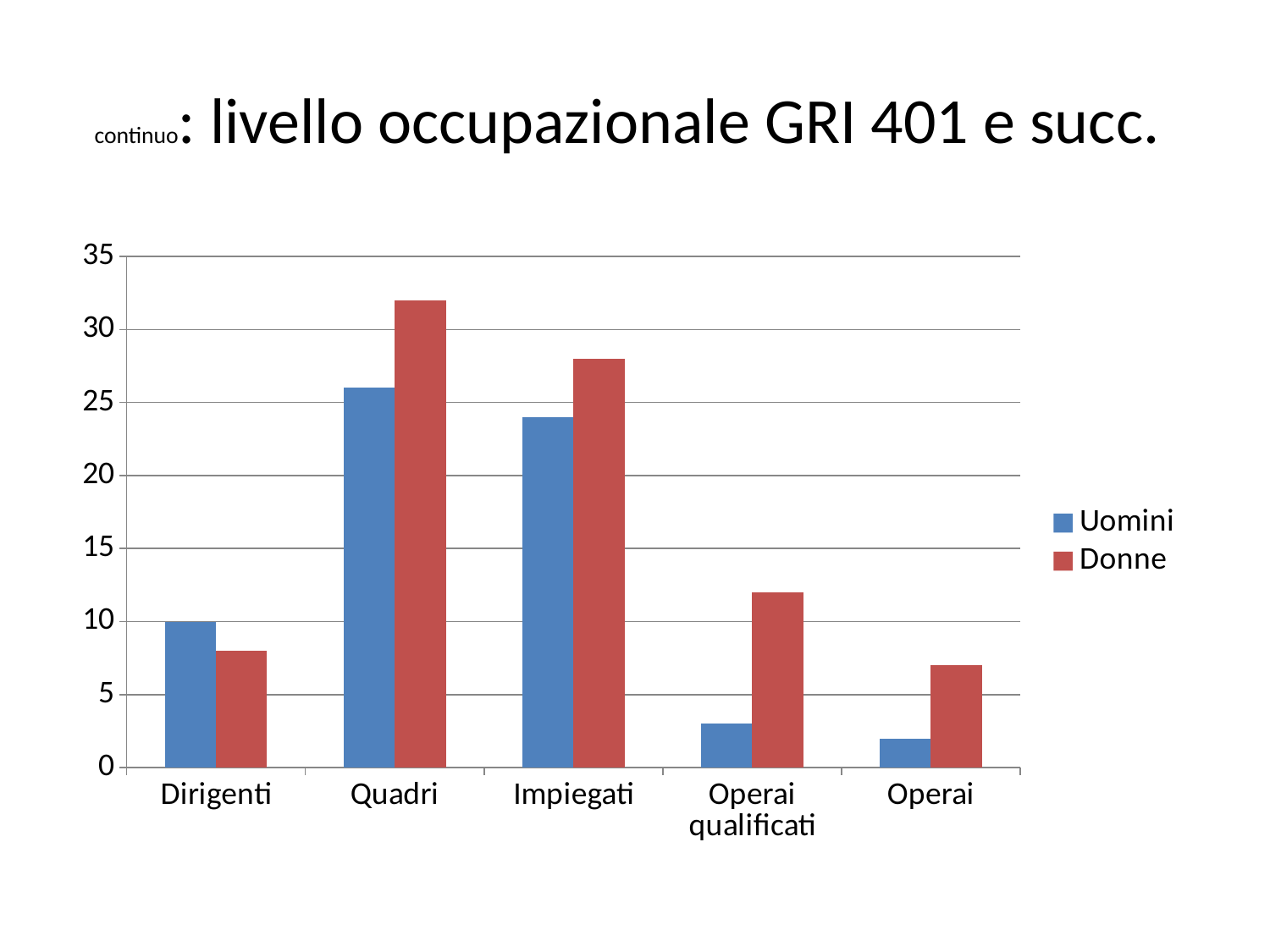
What kind of chart is shown on the slide? bar chart Which category has the highest Uomini value? Quadri Which series is shown in red? Donne How many categories are shown on the x axis? 5 What is the Uomini value for Dirigenti? 10 Which category has the lowest Uomini value? Operai For Dirigenti, which is larger, the Uomini value or the Donne value? Uomini Is the Donne value for Impiegati greater or less than 25? greater Is the Uomini value for Operai qualificati greater or less than 5? less Which category has the highest Donne value? Quadri How many series does the legend list? 2 Is the Donne value for Quadri greater or less than 30? greater